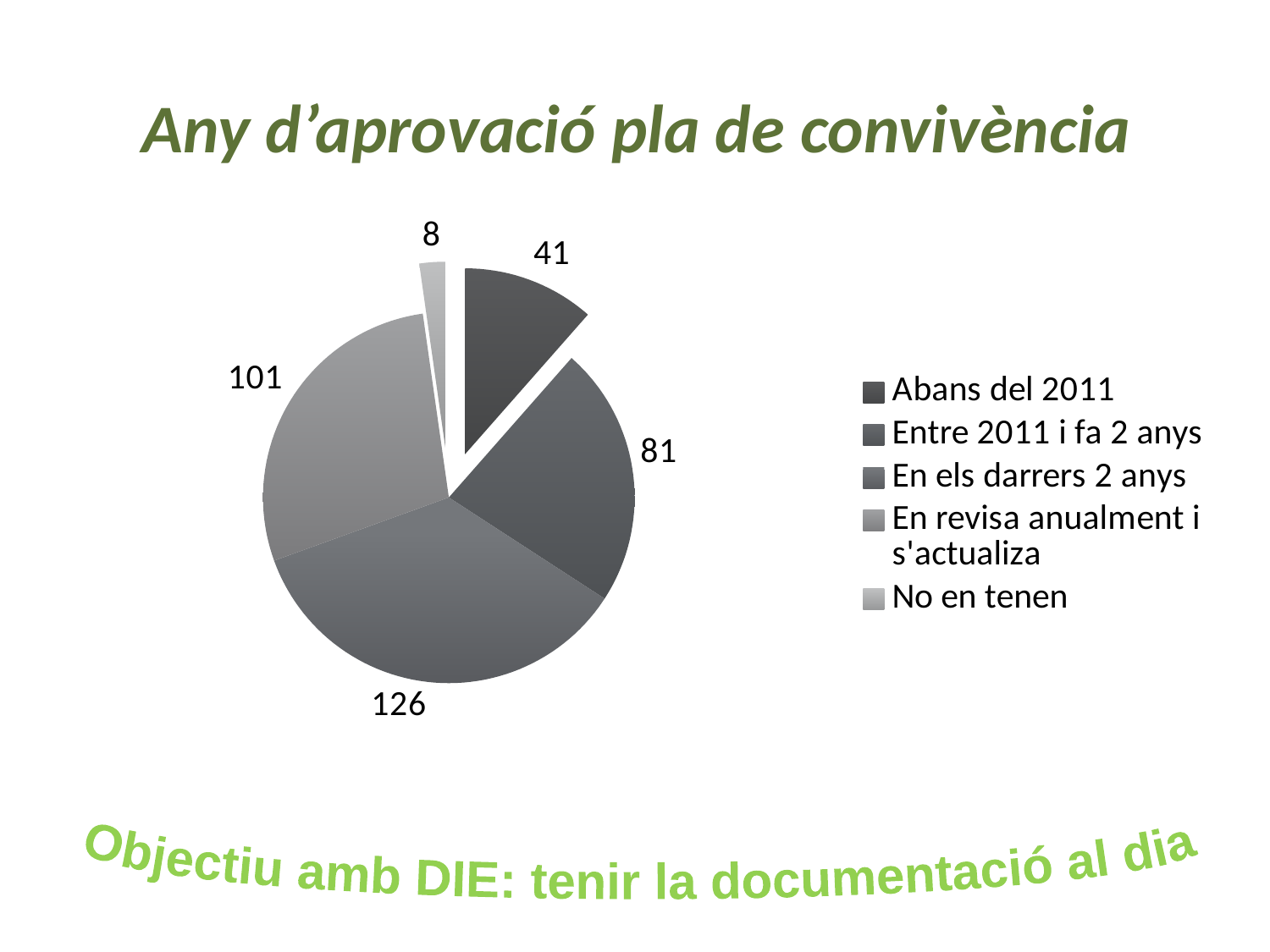
What is the title of the chart on the slide? Any d'aprovació pla de convivència What value is shown for the 'Abans del 2011' slice? 41 Which category has the largest slice of the pie? En els darrers 2 anys What value is shown for the 'No en tenen' slice? 8 How many slices does the pie chart have? 5 What is the difference between the 'En els darrers 2 anys' value and the 'Entre 2011 i fa 2 anys' value? 45 Which is larger: 'En revisa anualment i s'actualiza' or 'Entre 2011 i fa 2 anys'? En revisa anualment i s'actualiza What is the total of all the slice values in the pie chart? 357 What value is shown for the 'En els darrers 2 anys' slice? 126 What value is shown for the 'En revisa anualment i s'actualiza' slice? 101 What type of chart is shown on the slide? Pie chart Which category has the smallest slice of the pie? No en tenen